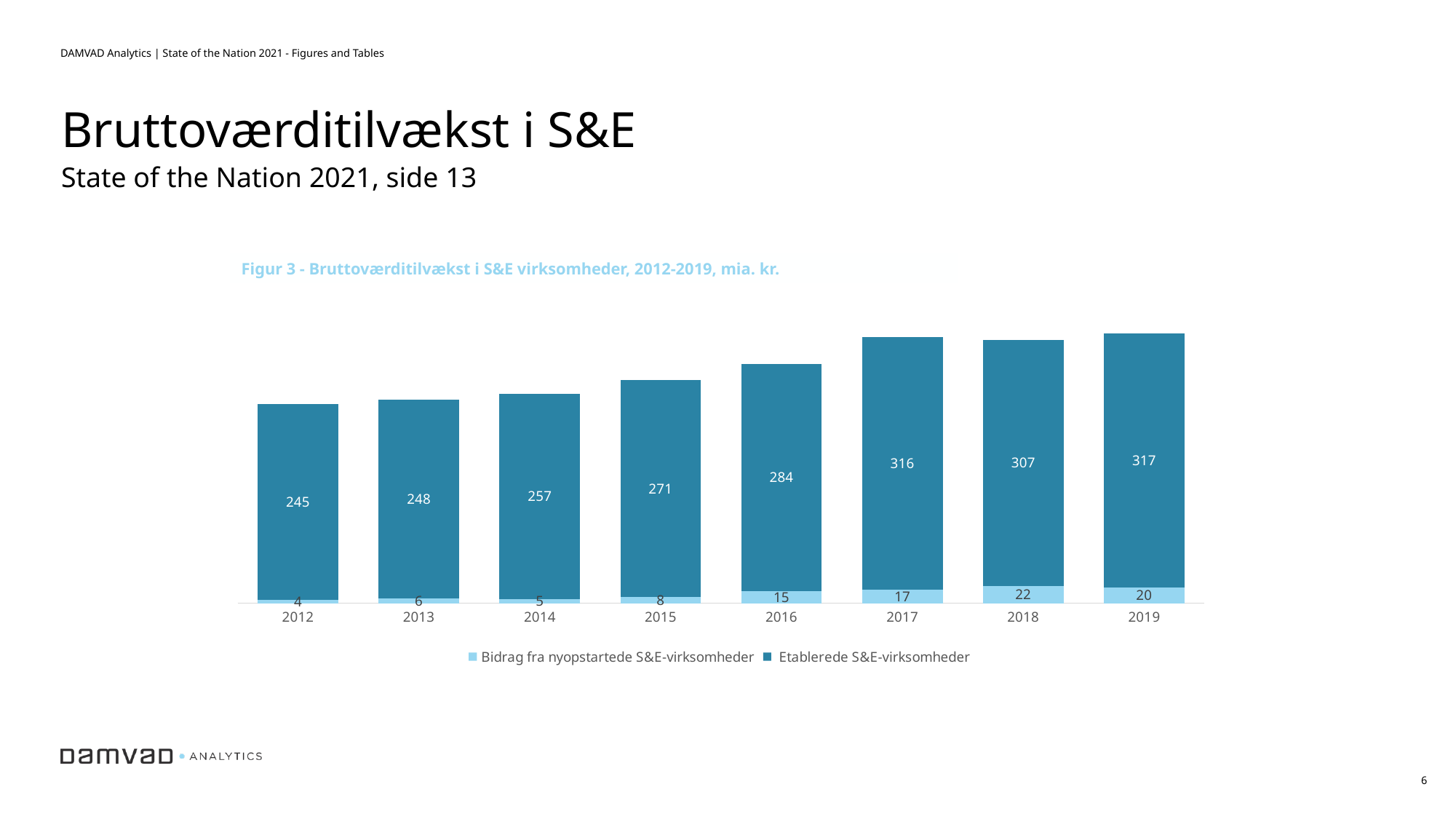
Is the Etablerede S&E-virksomheder value larger in 2017 or in 2018? 2017 What is the total of the stacked bar for 2019? 337 Do the Bidrag fra nyopstartede S&E-virksomheder values generally rise or fall from 2012 to 2018? Rise What is the difference between the Etablerede S&E-virksomheder values for 2017 and 2012? 71 What kind of chart is shown? Stacked bar chart Which year has the lowest value for Bidrag fra nyopstartede S&E-virksomheder? 2012 Which year has the highest value for Etablerede S&E-virksomheder? 2019 How many series does the legend list? 2 What is the value for Etablerede S&E-virksomheder in 2016? 284 What is the value for Bidrag fra nyopstartede S&E-virksomheder in 2018? 22 How many years are shown on the x axis? 8 What is the title of the figure? Figur 3 - Bruttoværditilvækst i S&E virksomheder, 2012-2019, mia. kr.